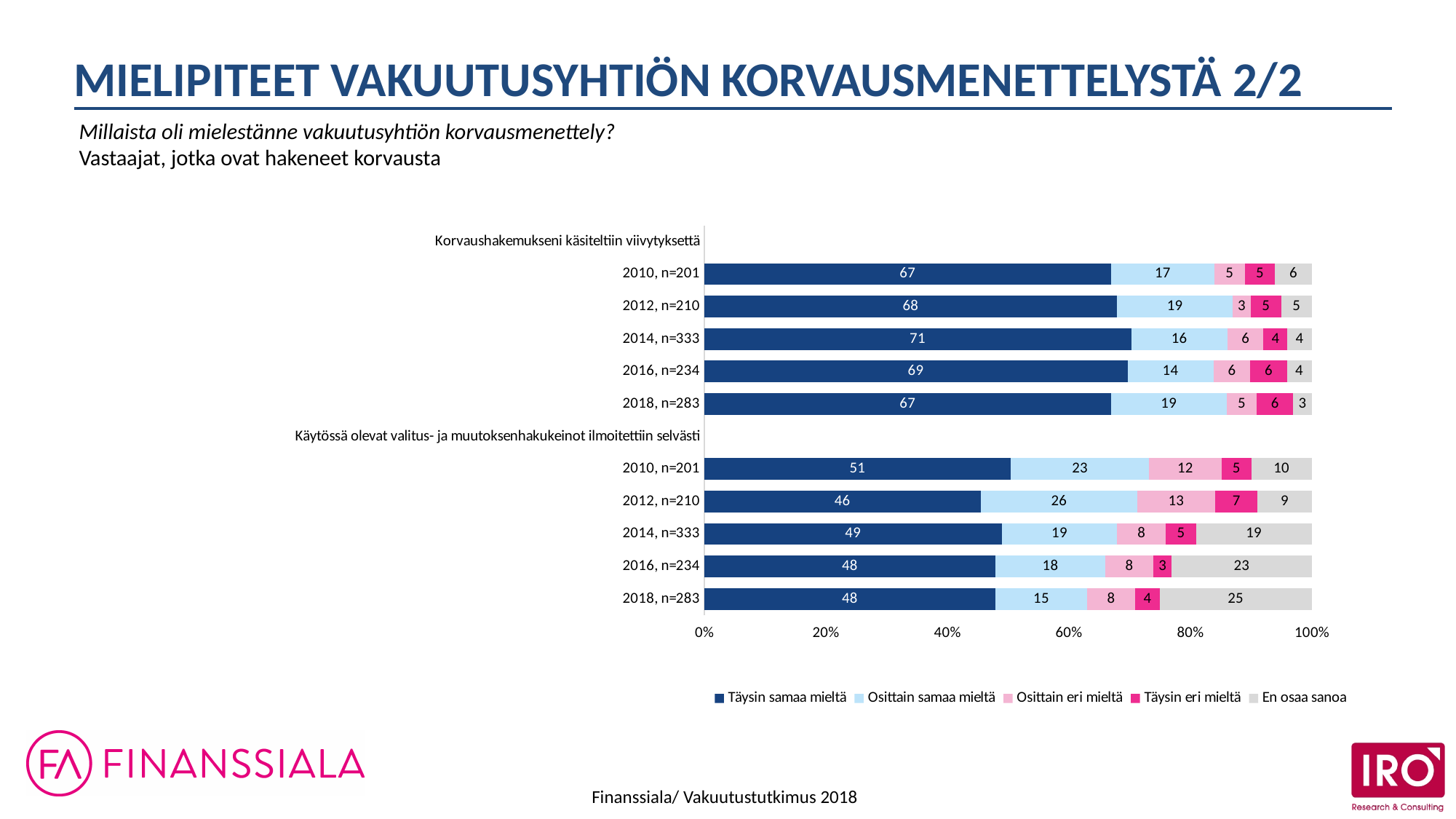
Under "Käytössä olevat valitus- ja muutoksenhakukeinot ilmoitettiin selvästi", is the "En osaa sanoa" value larger for 2016, n=234 or for 2014, n=333? 2016, n=234 What is the difference between the "Täysin samaa mieltä" values for 2010, n=201 in the two statement groups? 16 How many bars are plotted in the chart in total? 10 Which legend entry is shown in dark blue? Täysin samaa mieltä What is the value of "Täysin samaa mieltä" for 2014, n=333 under "Korvaushakemukseni käsiteltiin viivytyksettä"? 71 What is the value of "En osaa sanoa" for 2018, n=283 under "Käytössä olevat valitus- ja muutoksenhakukeinot ilmoitettiin selvästi"? 25 How many series does the legend list? 5 Under "Korvaushakemukseni käsiteltiin viivytyksettä", which year has the highest "Täysin samaa mieltä" value? 2014, n=333 What kind of chart is shown on the slide? Stacked bar chart What is the value of "Osittain samaa mieltä" for 2012, n=210 under "Käytössä olevat valitus- ja muutoksenhakukeinot ilmoitettiin selvästi"? 26 Under "Käytössä olevat valitus- ja muutoksenhakukeinot ilmoitettiin selvästi", does the "En osaa sanoa" value rise or fall from 2012 to 2018? Rise Under "Käytössä olevat valitus- ja muutoksenhakukeinot ilmoitettiin selvästi", which year has the lowest "Täysin samaa mieltä" value? 2012, n=210